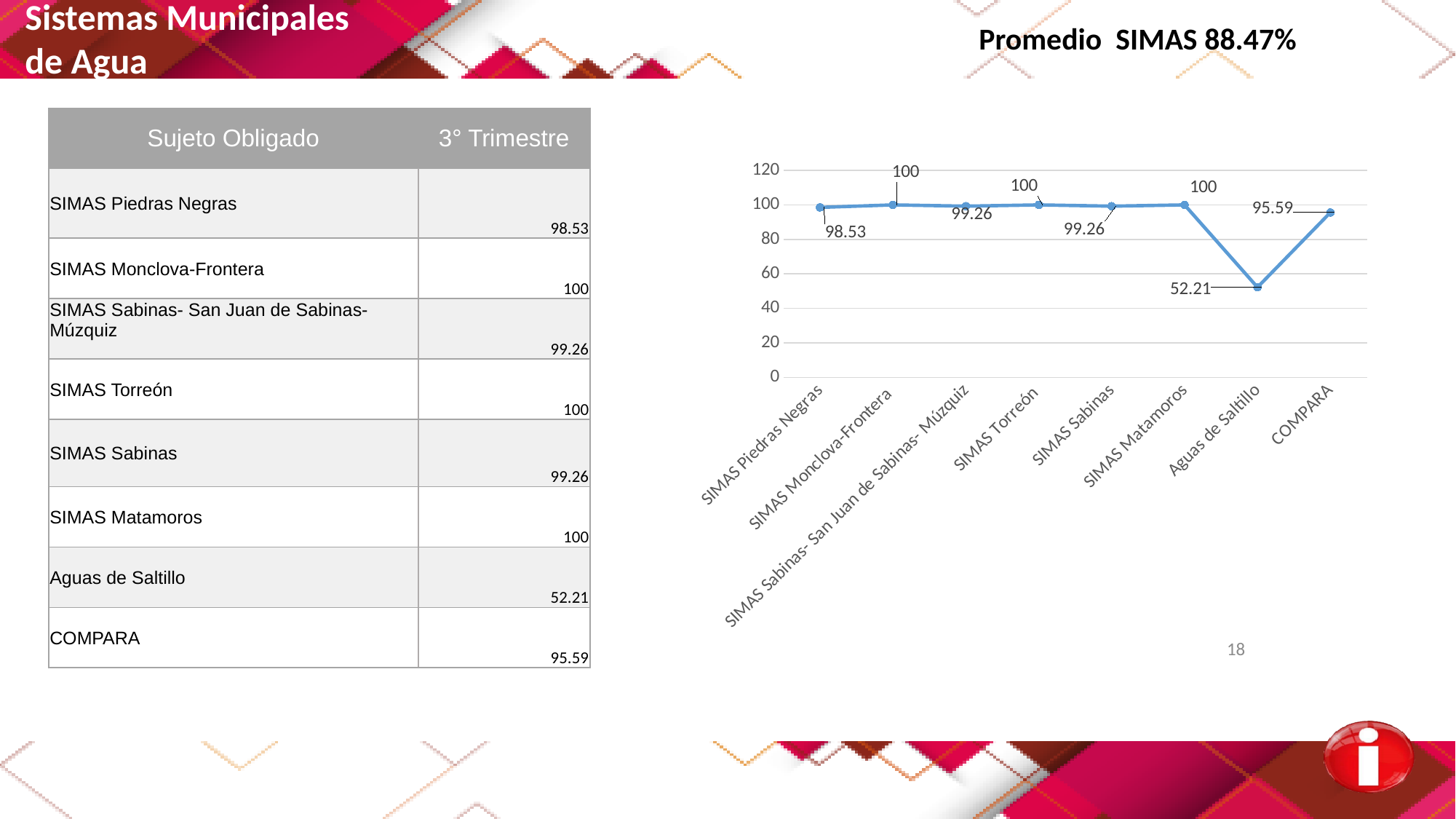
What is the value for SIMAS Sabinas in the chart? 99.26 How many categories are plotted on the x axis of the chart? 8 What kind of chart is shown on the slide? line chart Which category has the lowest value in the chart? Aguas de Saltillo What is the value for COMPARA in the chart? 95.59 Which is larger, the value for SIMAS Matamoros or the value for COMPARA? SIMAS Matamoros What is the difference between the values for COMPARA and SIMAS Piedras Negras? 2.94 What is the value for Aguas de Saltillo in the chart? 52.21 Is the value for Aguas de Saltillo greater or less than 60? less What is the value for SIMAS Piedras Negras in the chart? 98.53 What is the difference between the values for SIMAS Torreón and Aguas de Saltillo? 47.79 How many categories in the chart have a value of 100? 3